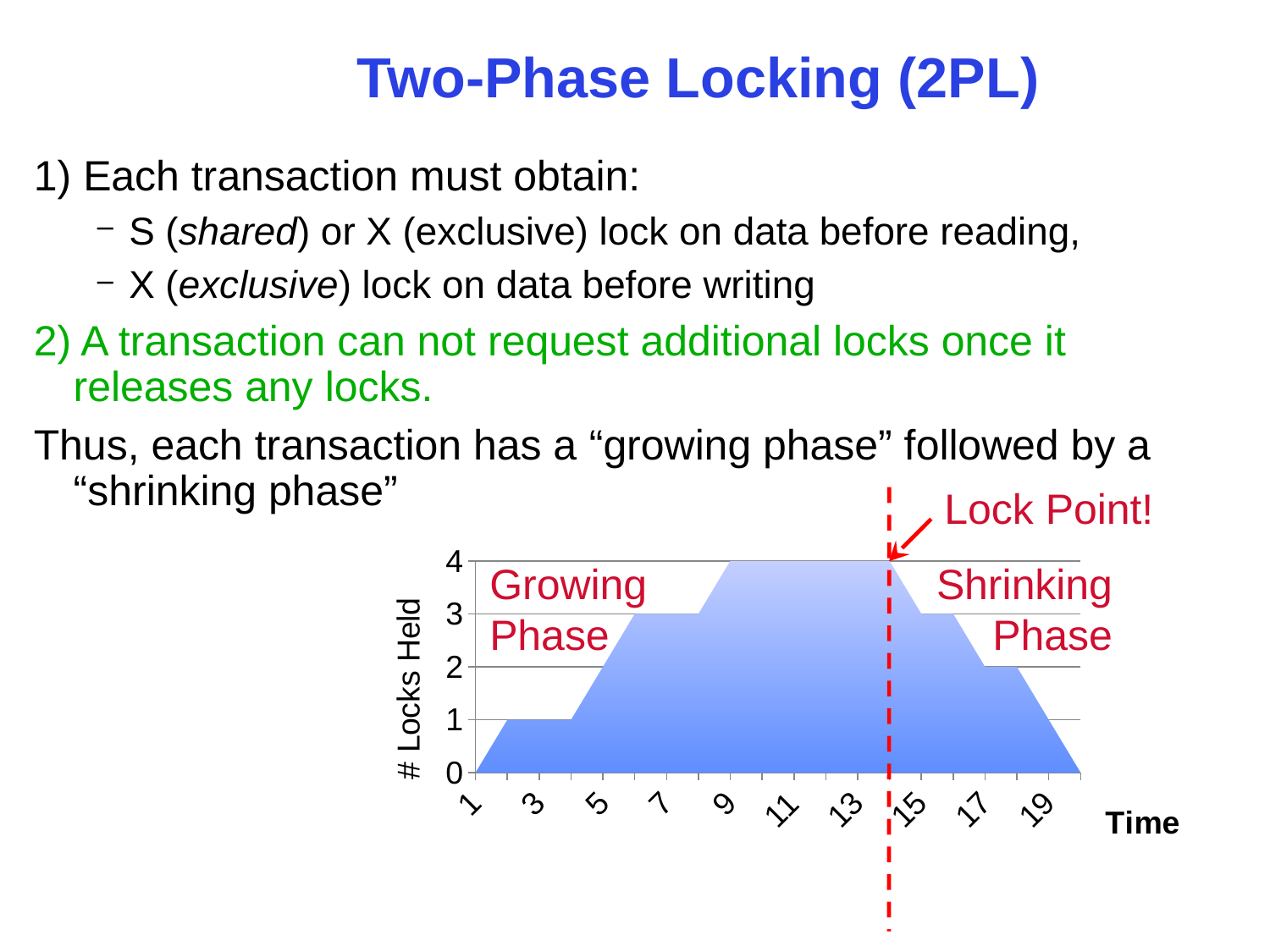
Does the number of locks held rise or fall along the Time axis after the Lock Point? fall What is the label of the vertical axis of the chart? # Locks Held What is the lowest number of locks held shown in the chart? 0 How many tick labels are shown on the Time axis? 10 What kind of chart is shown on the slide? area chart Is the number of locks held at time 13 greater or less than 3? greater Is the number of locks held at time 3 greater or less than 2? less What is the label of the horizontal axis of the chart? Time What is the maximum number of locks held shown in the chart? 4 Is the number of locks held at time 19 greater or less than 2? less